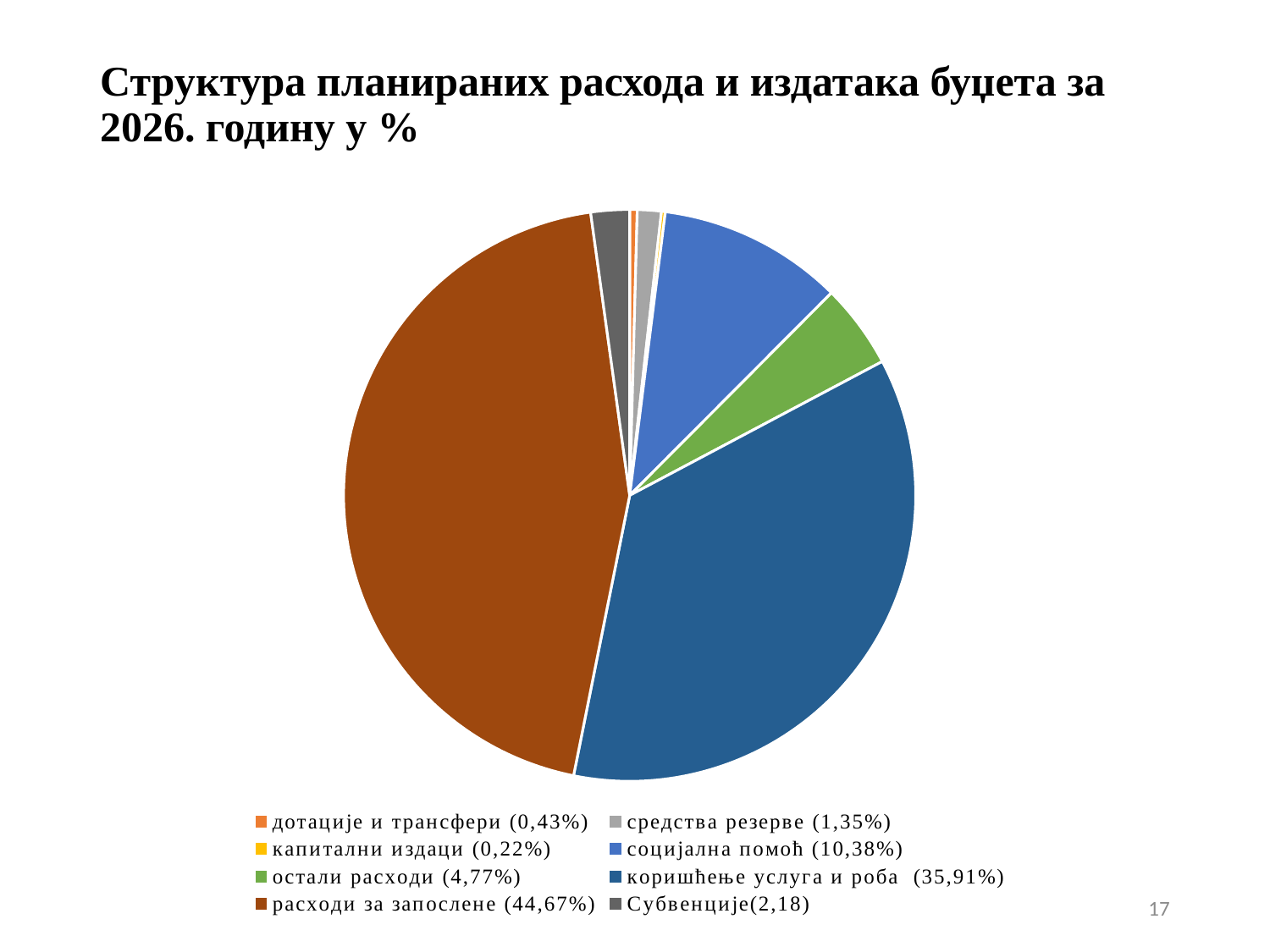
What share of the budget is planned for социјална помоћ? 10,38% What share of the budget is planned for расходи за запослене? 44,67% Which category has the smallest share of the pie? капитални издаци What share of the budget is planned for коришћење услуга и роба? 35,91% How many categories does the pie chart have? 8 What kind of chart is shown on the slide? pie chart What is the title of the chart on the slide? Структура планираних расхода и издатака буџета за 2026. годину у % What is the difference in percentage points between расходи за запослене and коришћење услуга и роба? 8,76 What colour is the slice for социјална помоћ? blue Which is larger, the share for остали расходи or the share for Субвенције? остали расходи What share of the budget is planned for капитални издаци? 0,22% Which category has the largest share of the pie? расходи за запослене